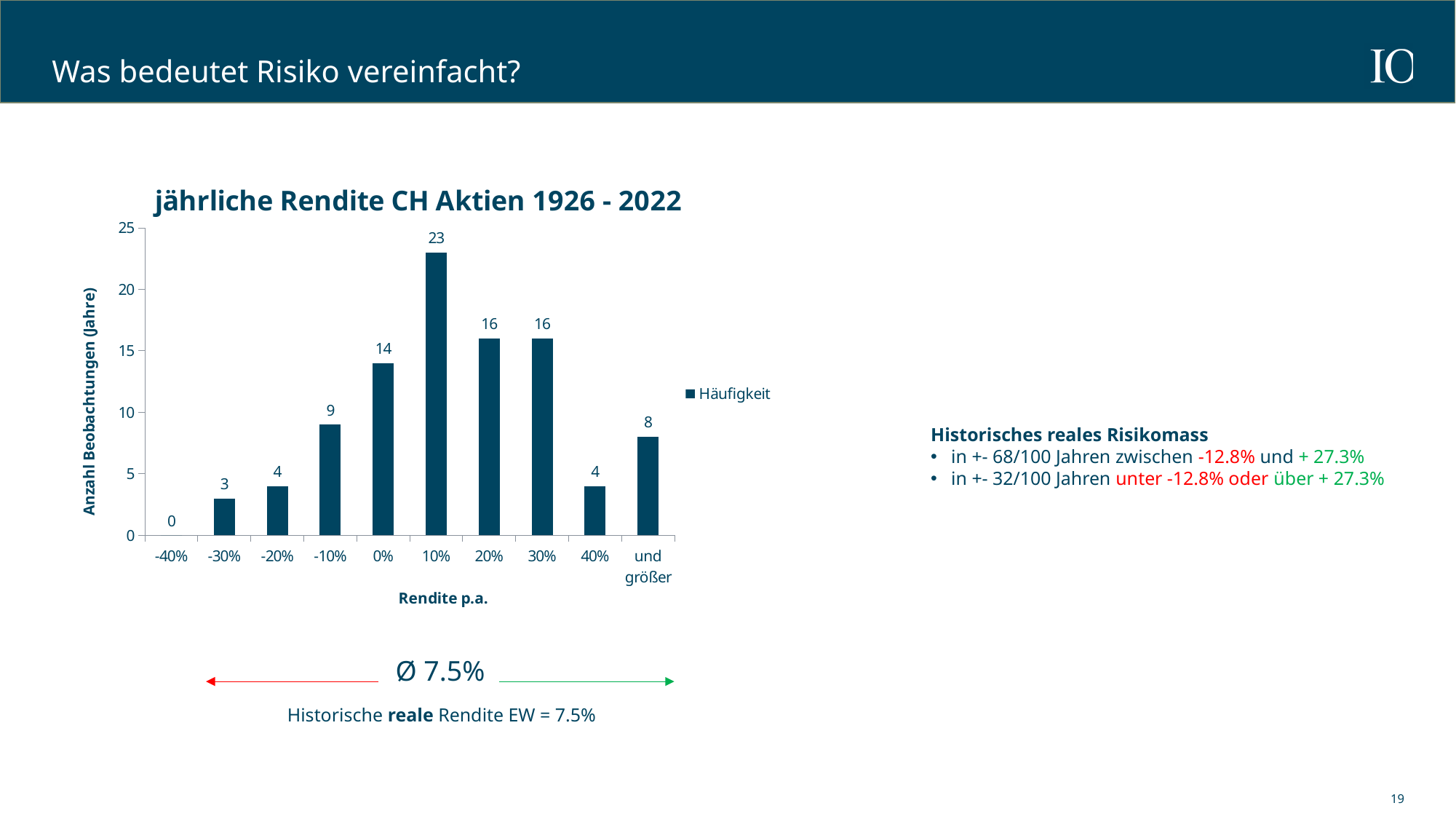
How many categories are shown on the x axis? 10 What kind of chart is shown? bar chart What is the value for the 10% category? 23 What is the value for the -30% category? 3 How many series does the legend list? 1 Which is larger, the value for -10% or the value for 40%? -10% What is the title of the chart? jährliche Rendite CH Aktien 1926 - 2022 What is the value for the 'und größer' category? 8 Which category has the highest value? 10% What is the difference between the values for 10% and 0%? 9 Which category has the lowest value? -40% Is the value for 20% greater or less than 15? greater